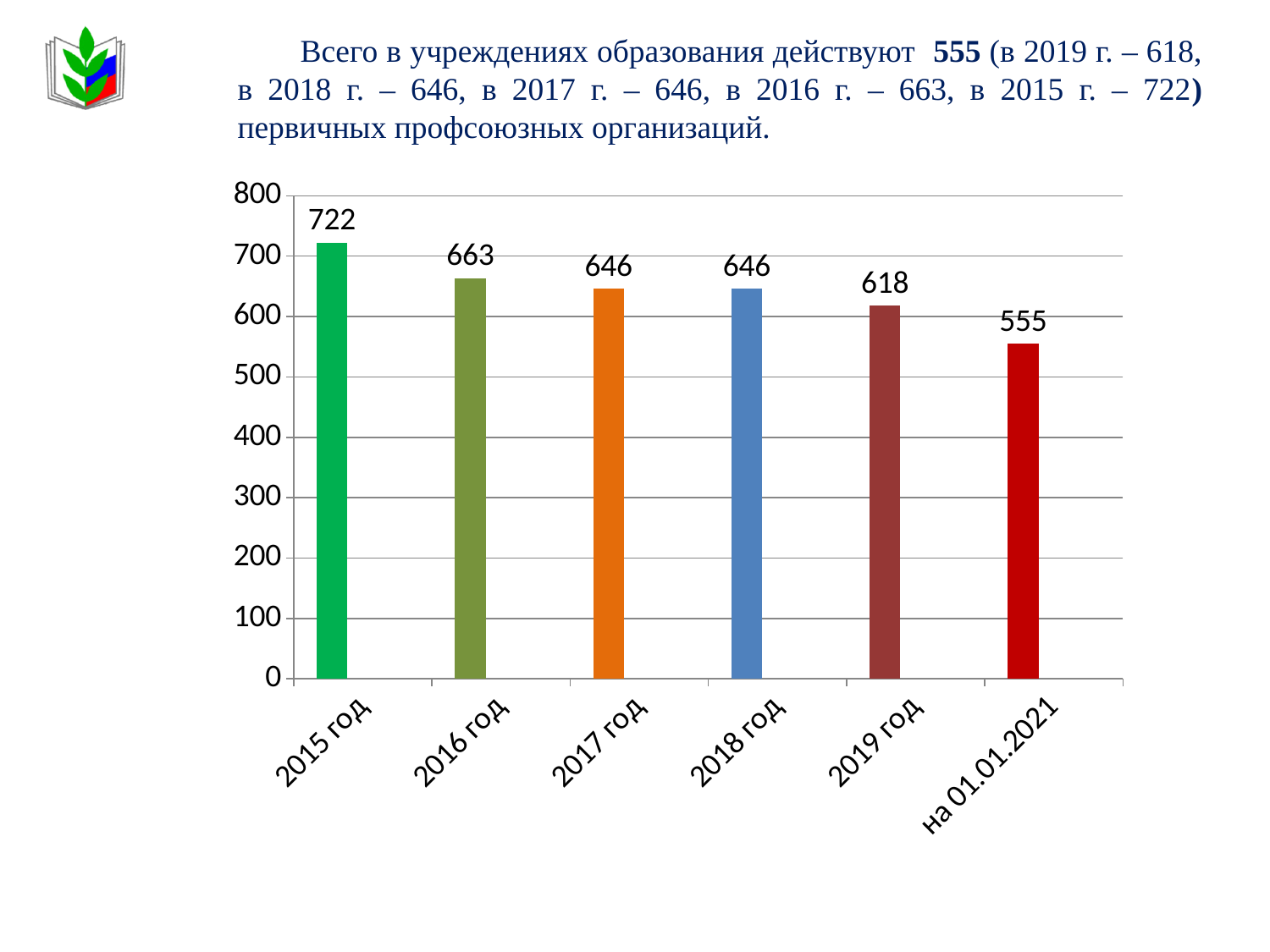
Which category has the highest value? 2015 год What is the difference between the values for 2015 год and на 01.01.2021? 167 Which category has the lowest value? на 01.01.2021 What is the value for 2015 год? 722 What is the value for 2019 год? 618 What is the value for на 01.01.2021? 555 What is the difference between the values for 2016 год and 2019 год? 45 How many categories are shown on the x axis? 6 Do the values rise or fall from 2015 год to на 01.01.2021? fall What kind of chart is this? bar chart What is the value for 2016 год? 663 Which is larger, the value for 2016 год or the value for 2019 год? 2016 год